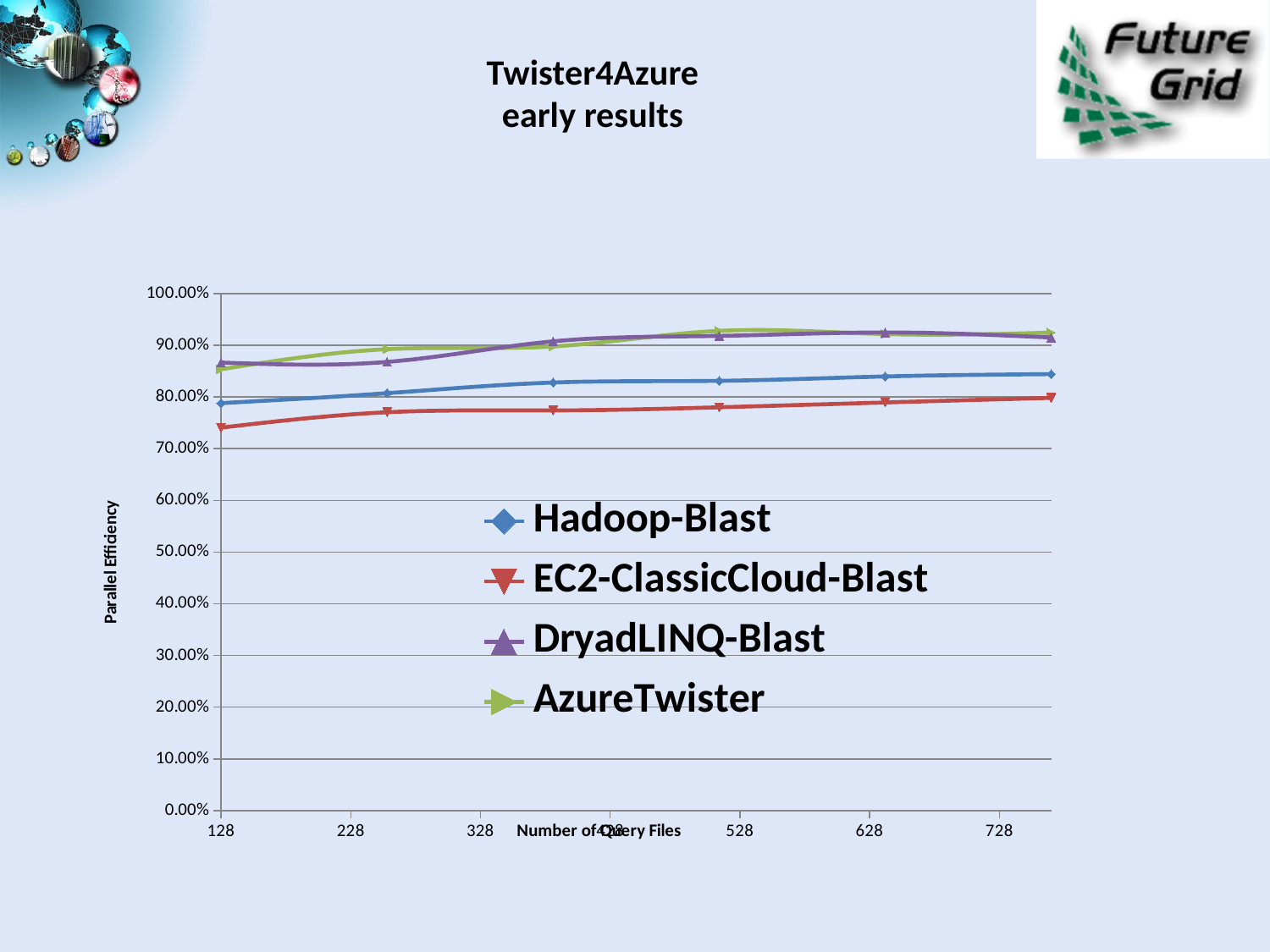
Is the value for Hadoop-Blast at 128 query files greater or less than 70.00%? greater What is the title of the y axis? Parallel Efficiency How many series does the legend list? 4 Is the value for AzureTwister at 528 query files greater or less than 90.00%? greater What is the title of the x axis? Number of Query Files Is the value for DryadLINQ-Blast at 128 query files greater or less than 80.00%? greater At 128 query files, which is larger: Hadoop-Blast or EC2-ClassicCloud-Blast? Hadoop-Blast Which series has the lowest parallel efficiency across the chart? EC2-ClassicCloud-Blast Does the EC2-ClassicCloud-Blast line rise or fall as the number of query files increases? rise At 128 query files, which is larger: DryadLINQ-Blast or Hadoop-Blast? DryadLINQ-Blast What kind of chart is shown on the slide? line chart